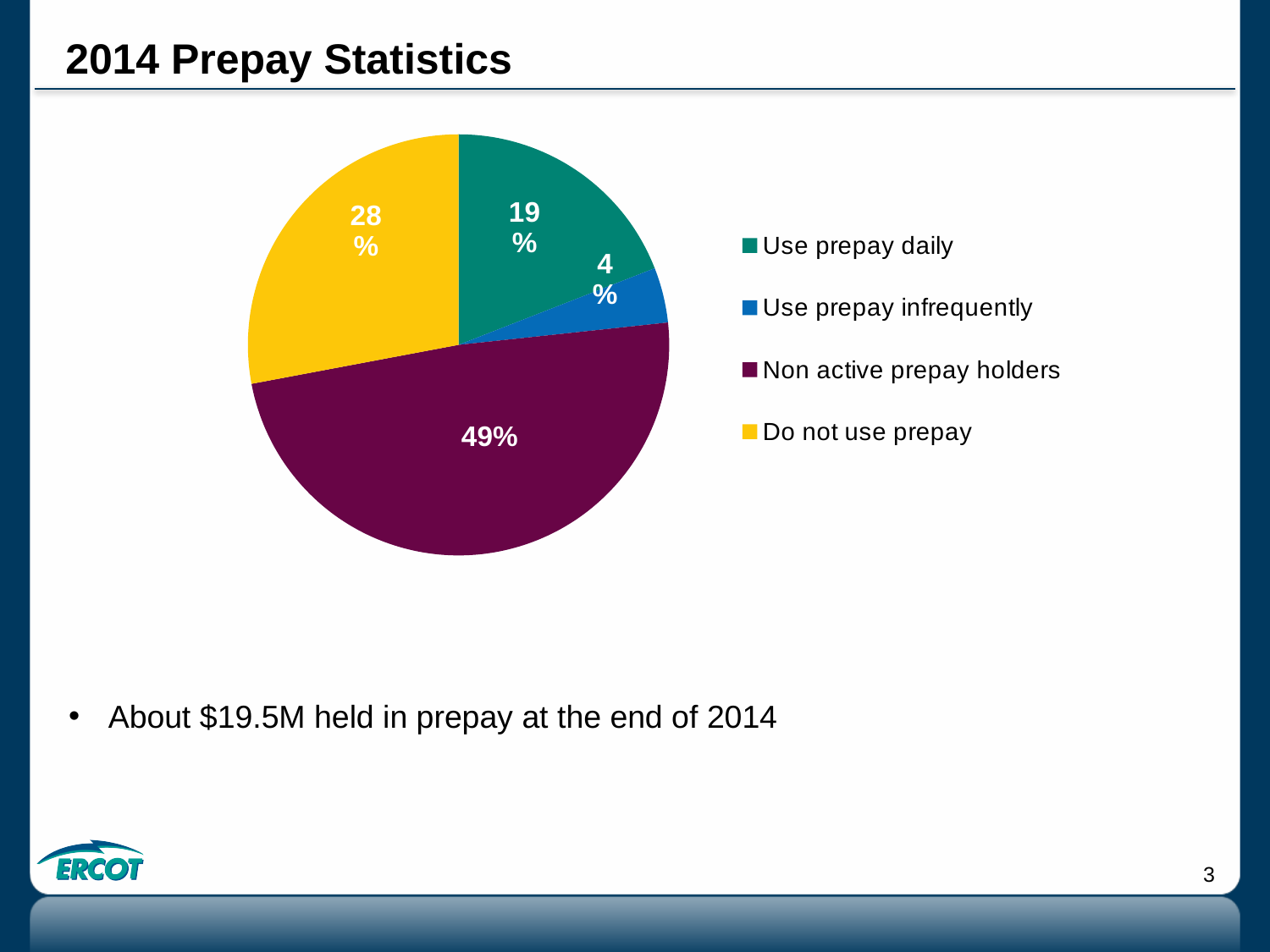
What share of the pie is labelled 'Use prepay daily'? 19% Which category has the largest slice of the pie? Non active prepay holders What share of the pie is labelled 'Do not use prepay'? 28% Which is larger, the share for 'Use prepay daily' or the share for 'Do not use prepay'? Do not use prepay What is the combined share of 'Use prepay daily' and 'Use prepay infrequently'? 23% What share of the pie is labelled 'Use prepay infrequently'? 4% What is the difference in percentage points between 'Non active prepay holders' and 'Do not use prepay'? 21 percentage points What colour is the slice for 'Do not use prepay'? Yellow What kind of chart is shown on the slide? Pie chart What share of the pie is labelled 'Non active prepay holders'? 49% How many slices does the pie chart have? 4 Which category has the smallest slice of the pie? Use prepay infrequently